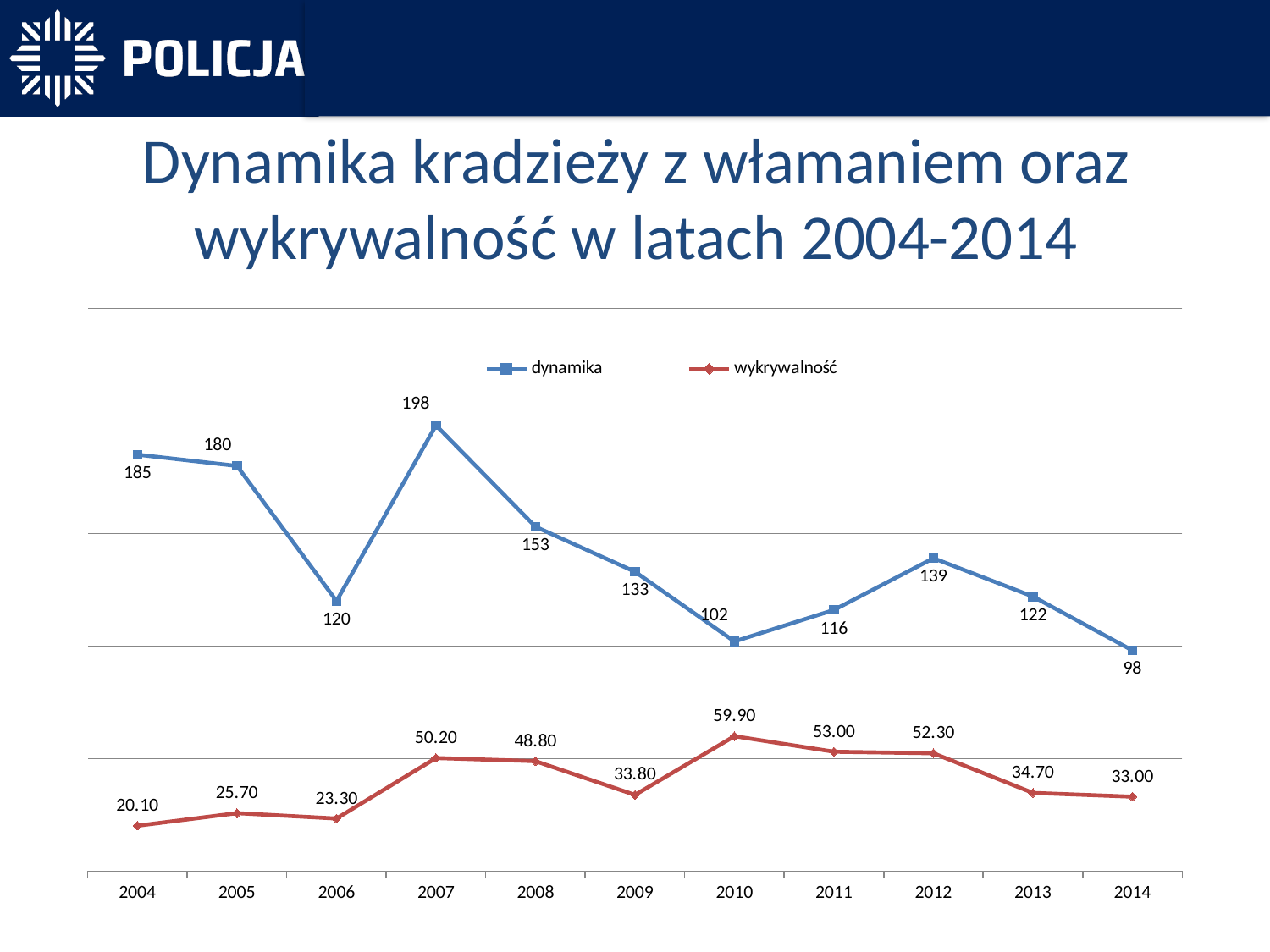
Does dynamika rise or fall from 2012 to 2014? fall What colour is the wykrywalność line? red How many years are shown on the x axis? 11 In which year is wykrywalność lowest? 2004 What kind of chart is shown on the slide? line chart What is the value of dynamika in 2007? 198 How many series does the legend list? 2 In which year is dynamika highest? 2007 What is the value of wykrywalność in 2010? 59.90 What is the difference between dynamika in 2004 and dynamika in 2014? 87 What is the value of dynamika in 2014? 98 Which is larger: wykrywalność in 2011 or wykrywalność in 2012? 2011